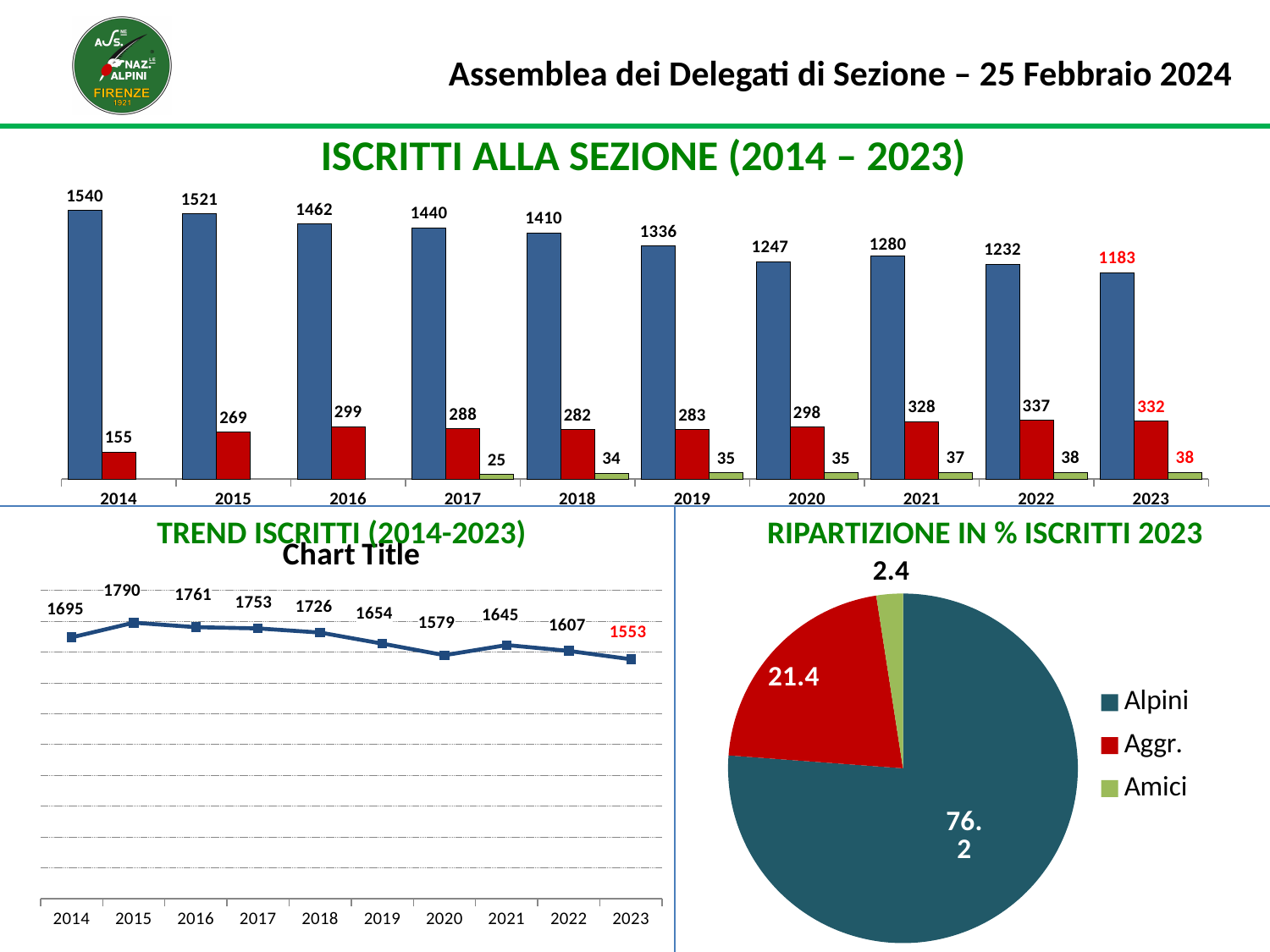
In the line chart 'TREND ISCRITTI (2014-2023)', what is the value for 2015? 1790 In the line chart 'TREND ISCRITTI (2014-2023)', which year has the highest value? 2015 In the top bar chart 'ISCRITTI ALLA SEZIONE (2014 – 2023)', what is the value of the blue bar for 2014? 1540 In the top bar chart 'ISCRITTI ALLA SEZIONE (2014 – 2023)', which year has the lowest blue bar? 2023 What kind of chart is 'TREND ISCRITTI (2014-2023)'? line chart In the top bar chart 'ISCRITTI ALLA SEZIONE (2014 – 2023)', what is the difference between the blue bar values for 2014 and 2023? 357 In the top bar chart 'ISCRITTI ALLA SEZIONE (2014 – 2023)', how many years are shown on the x axis? 10 In the line chart 'TREND ISCRITTI (2014-2023)', what is the difference between the values for 2015 and 2023? 237 How many entries does the legend of the pie chart 'RIPARTIZIONE IN % ISCRITTI 2023' list? 3 In the pie chart 'RIPARTIZIONE IN % ISCRITTI 2023', what is the value for Aggr.? 21.4 In the top bar chart 'ISCRITTI ALLA SEZIONE (2014 – 2023)', is the red bar for 2021 larger or smaller than the red bar for 2014? larger In the top bar chart 'ISCRITTI ALLA SEZIONE (2014 – 2023)', what is the value of the red bar for 2022? 337